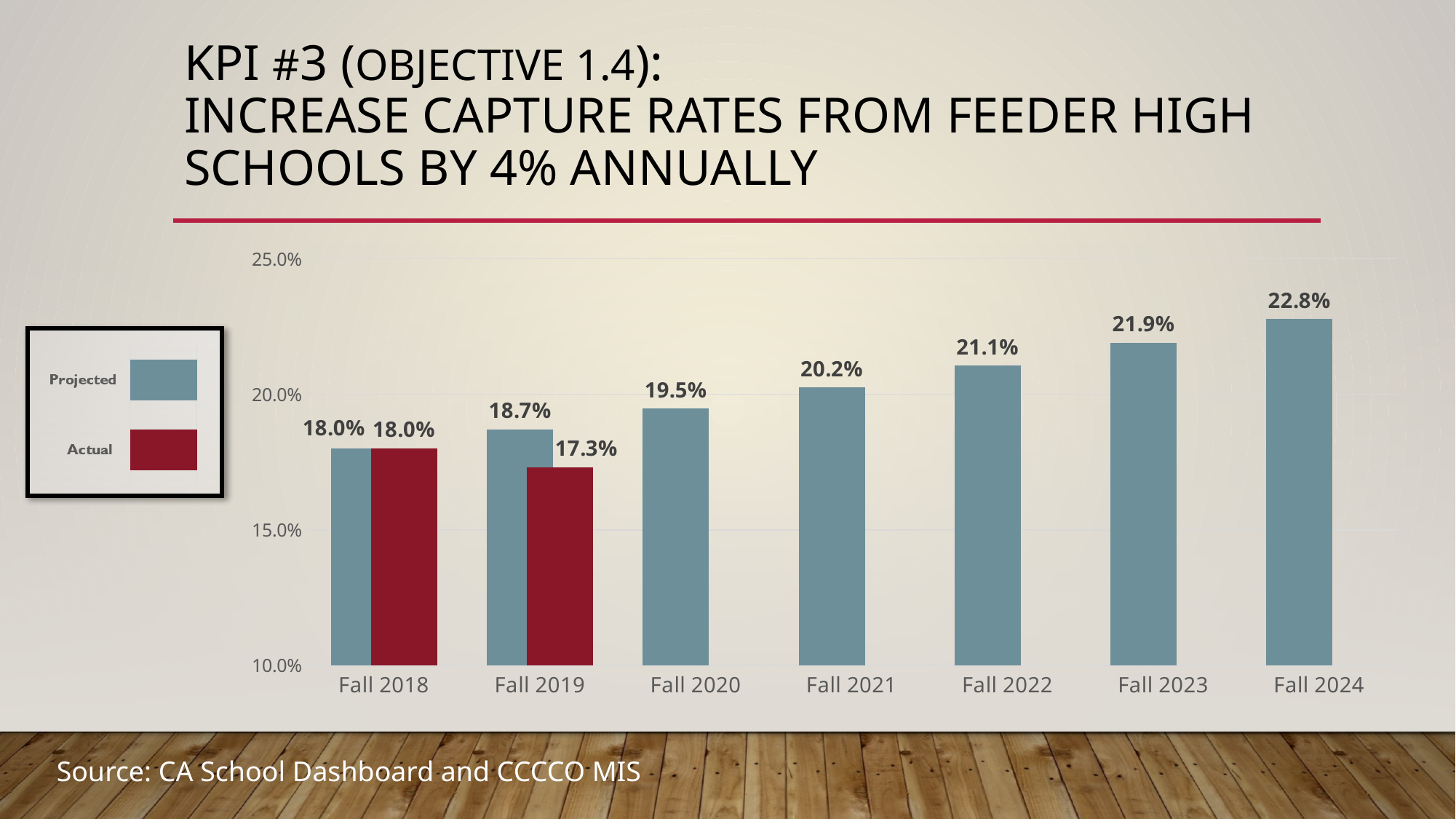
What kind of chart is shown on the slide? bar chart What is the Projected value for Fall 2024? 22.8% Do the Projected values rise or fall from Fall 2018 to Fall 2024? rise What is the Actual value for Fall 2019? 17.3% How many categories are shown on the x axis? 7 What is the difference between the Projected and Actual values for Fall 2019? 1.4% What is the Projected value for Fall 2020? 19.5% Which category has the lowest Projected value? Fall 2018 Which category has the highest Projected value? Fall 2024 How many series does the legend list? 2 Which is larger, the Projected value for Fall 2022 or the Projected value for Fall 2023? Fall 2023 Is the Projected value for Fall 2021 greater or less than 20.0%? greater